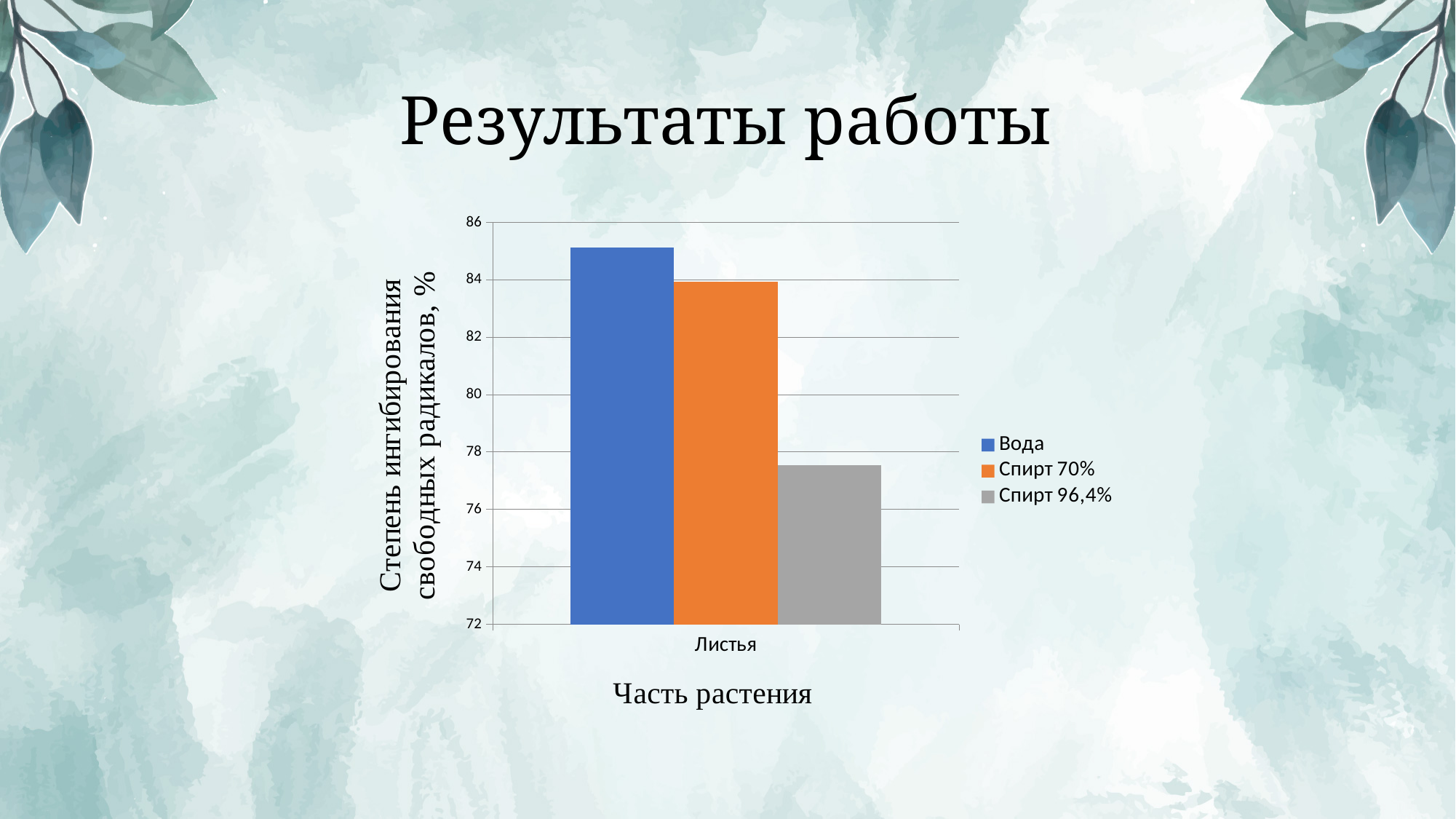
Is the value for Вода greater or less than 84? greater Which is larger for Листья: the value for Вода or the value for Спирт 96,4%? Вода What colour is the bar for Спирт 70%? orange What kind of chart is shown on the slide? bar chart Which is larger for Листья: the value for Спирт 70% or the value for Спирт 96,4%? Спирт 70% Which series has the highest value for Листья? Вода What is the title of the x axis? Часть растения Is the value for Спирт 70% greater or less than 82? greater Which series has the lowest value for Листья? Спирт 96,4% How many series does the legend list? 3 How many categories are shown on the x axis? 1 Is the value for Спирт 96,4% greater or less than 78? less